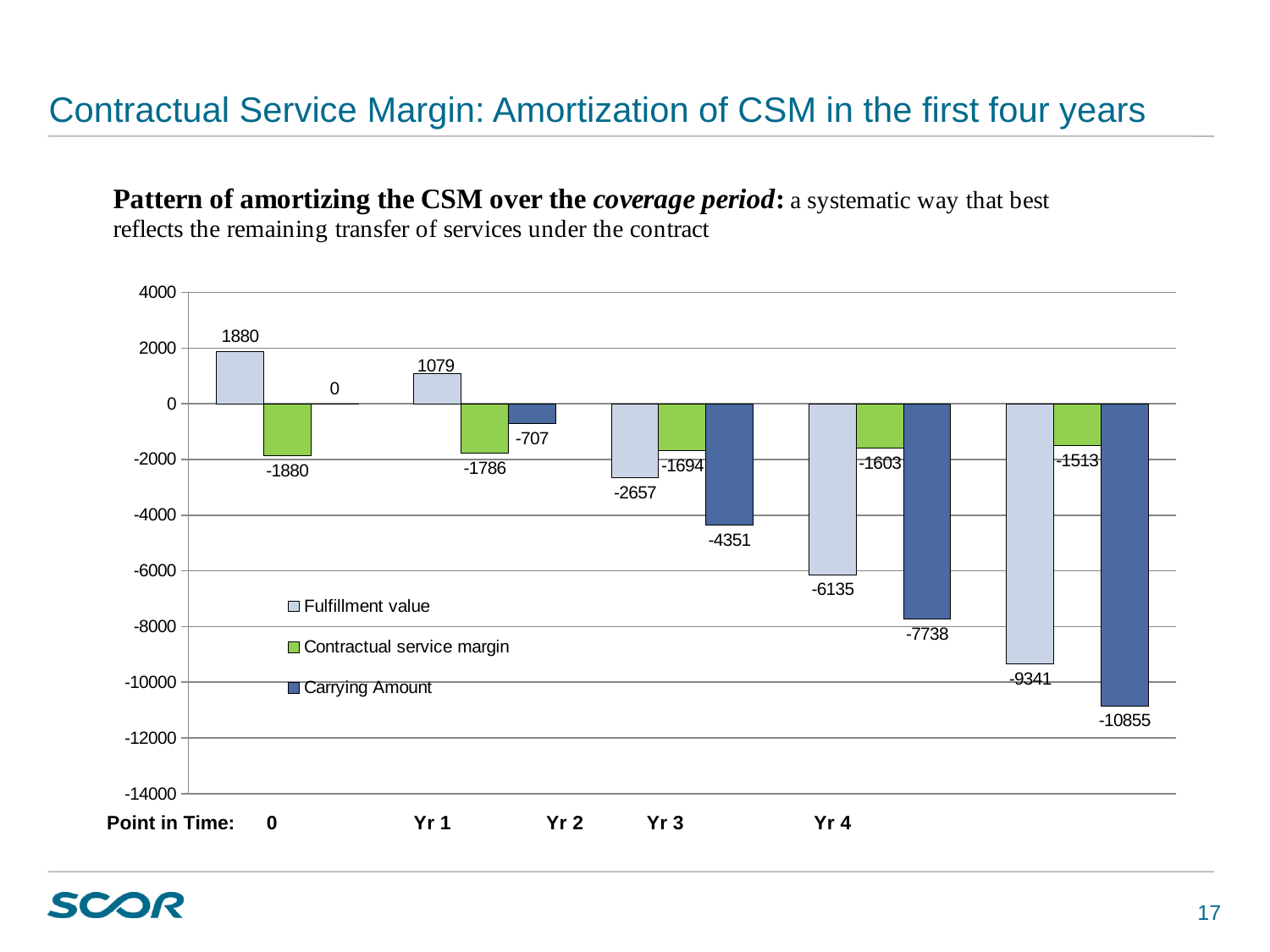
How many series does the legend list? 3 What is the difference between the Carrying Amount in the rightmost group (-10855) and in the fourth group from the left (-7738)? 3117 What kind of chart is shown on the slide? bar chart What is the Carrying Amount at point in time 0 (the leftmost group)? 0 Does the Fulfillment value rise or fall from left to right across the groups? fall Which group of bars has the lowest Carrying Amount? the rightmost group, -10855 What is the Fulfillment value at point in time 0 (the leftmost group)? 1880 Which is larger: the Contractual service margin in the leftmost group or in the rightmost group? the rightmost group (-1513) What is the Carrying Amount in the rightmost group of bars? -10855 How many groups of bars (points in time) are plotted in the chart? 5 What is the Contractual service margin in the second group of bars from the left? -1786 Which group of bars has the highest Fulfillment value? the leftmost group (point in time 0), 1880